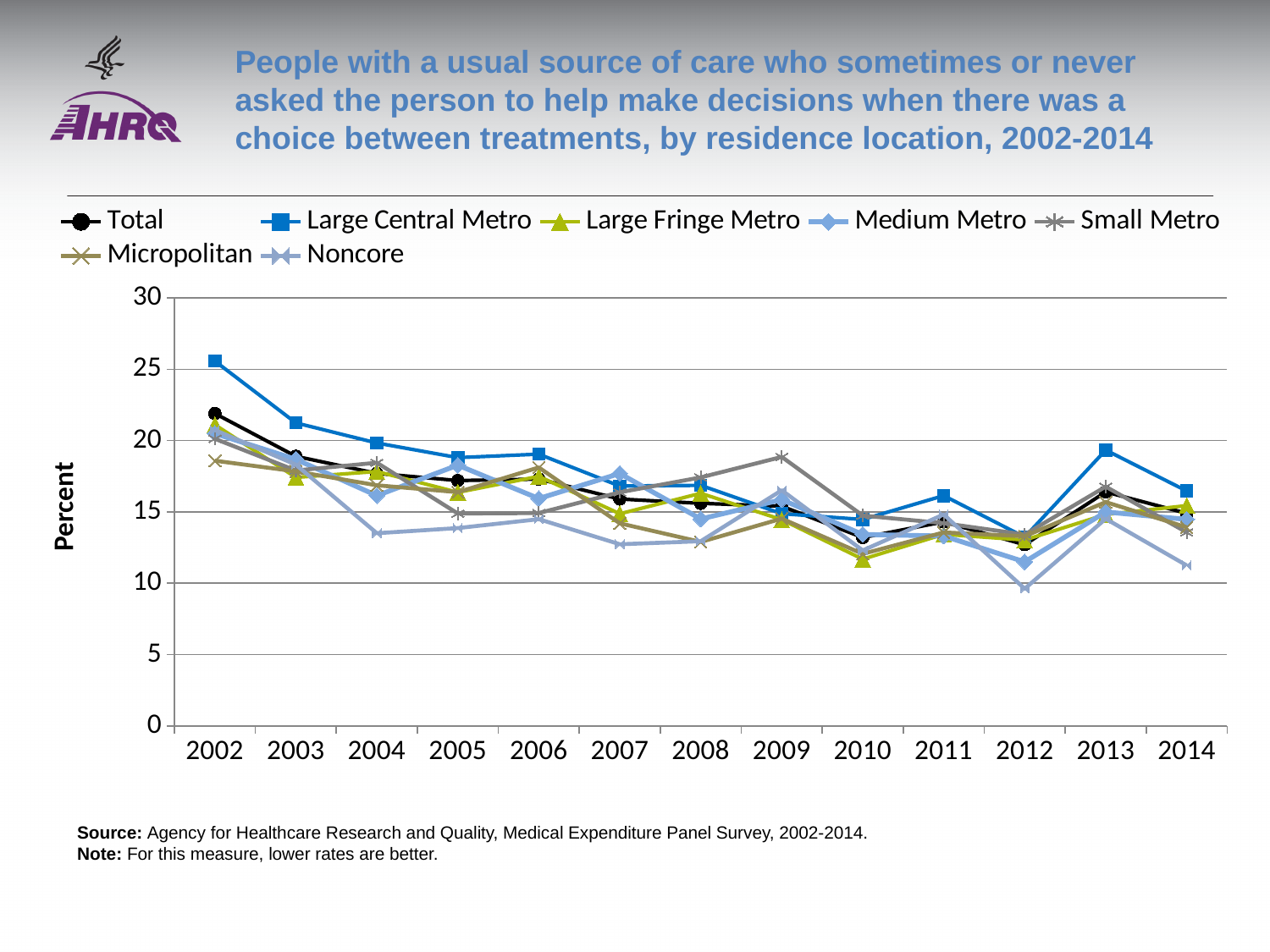
Which series has the highest value in 2009? Small Metro How many years are shown along the x axis? 13 Is the value for Noncore in 2014 greater or less than 15? less What kind of chart is shown on the slide? line chart Is the value for Noncore in 2012 greater or less than 10? less In 2002, which is larger: the value for Large Central Metro or the value for Total? Large Central Metro What is the label on the y axis? Percent How many series does the legend list? 7 Is the value for Total in 2002 greater or less than 20? greater Which series has the highest value in 2002? Large Central Metro Which series has the lowest value in 2012? Noncore Does the Total series generally rise or fall from 2002 to 2014? fall